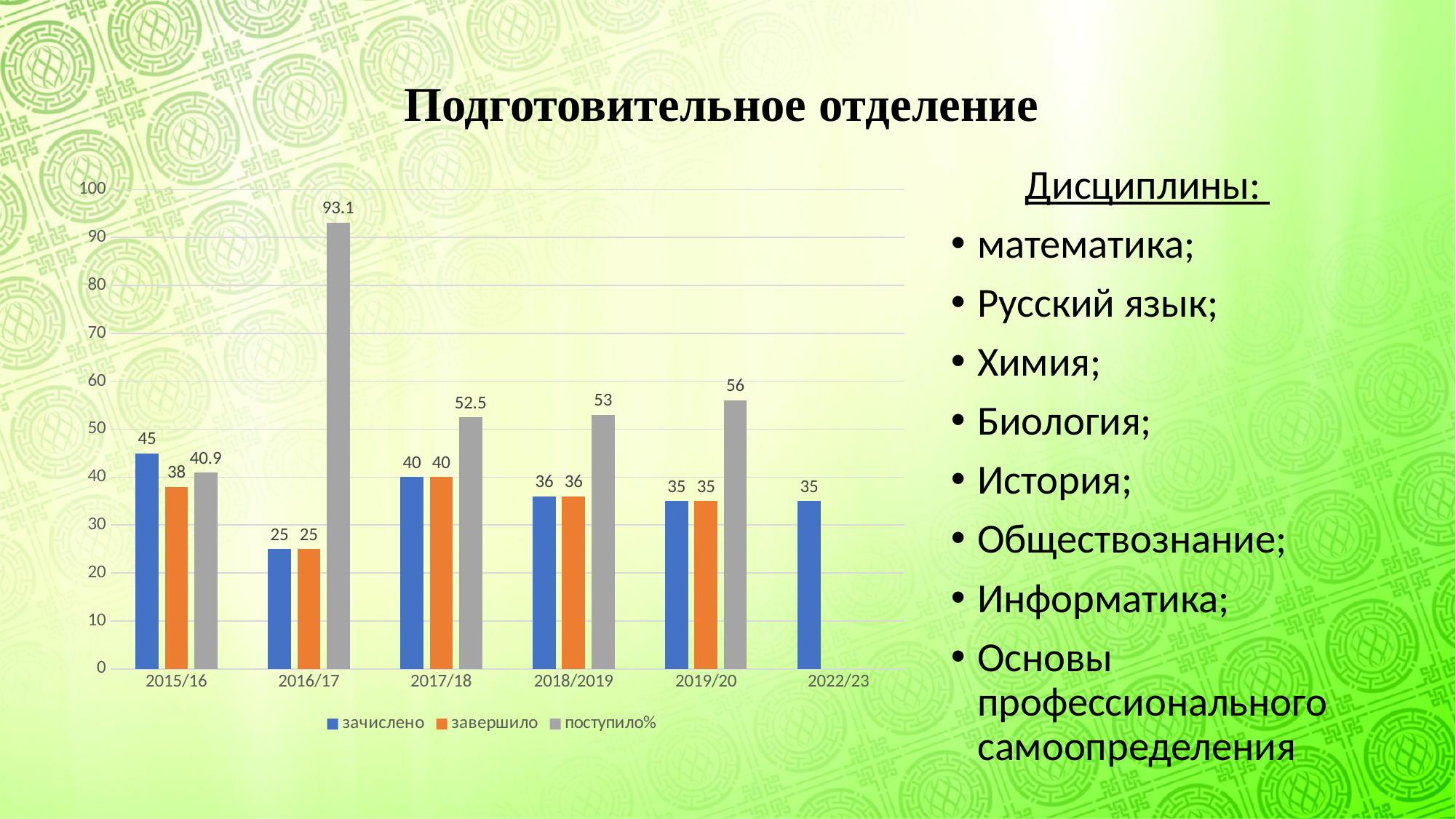
What is the value of завершило for 2017/18? 40 How many series does the legend list? 3 Which year has the highest value of поступило%? 2016/17 How many year categories are shown on the x axis? 6 What is the value of поступило% for 2019/20? 56 Which year has the lowest value of зачислено? 2016/17 What is the difference between зачислено and завершило for 2015/16? 7 What kind of chart is shown on the slide? bar chart Which is larger: поступило% for 2018/2019 or поступило% for 2017/18? 2018/2019 Which series is shown in gray in the legend? поступило% What is the value of зачислено for 2015/16? 45 What is the value of поступило% for 2016/17? 93.1